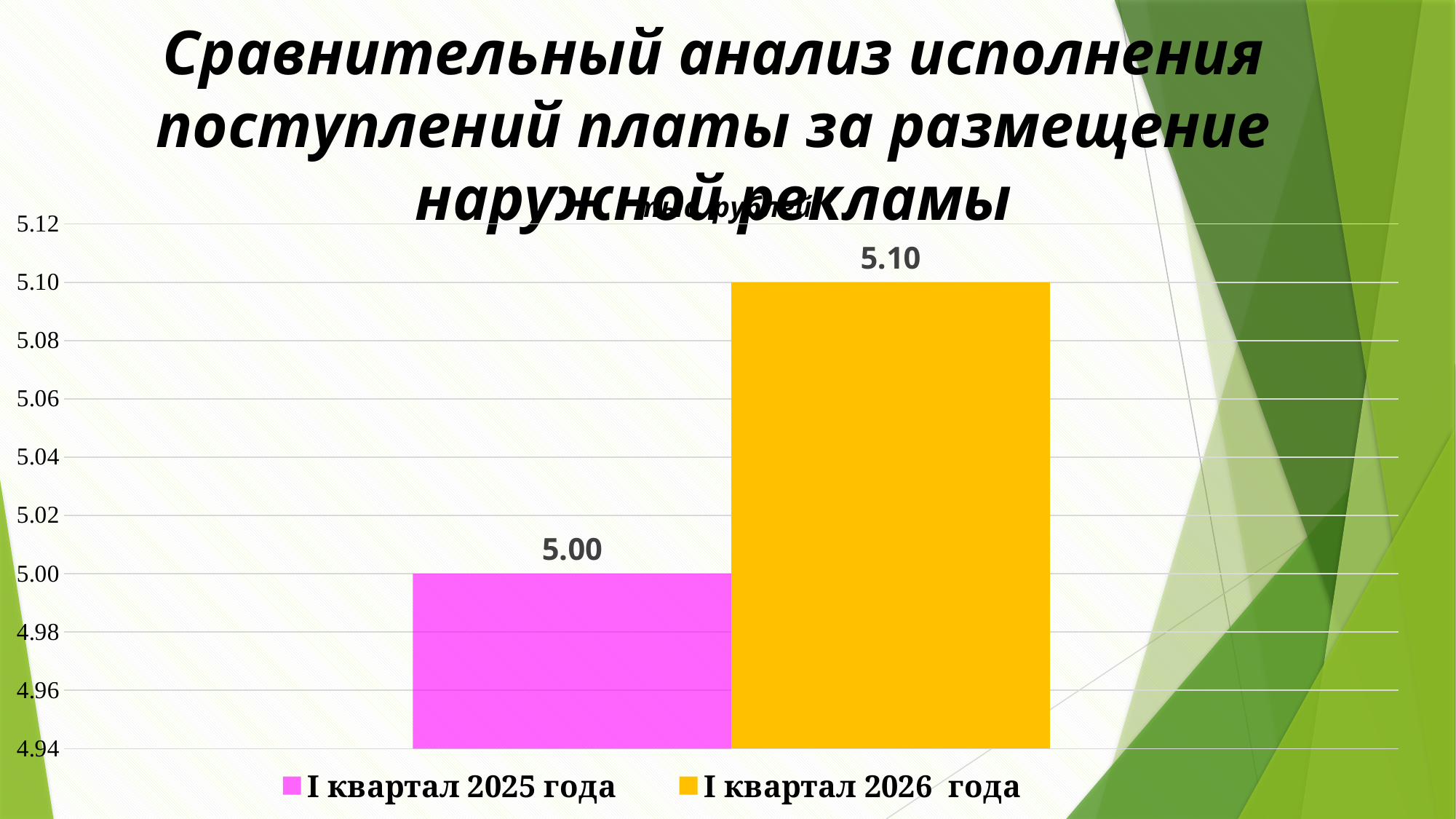
What is the difference between the values for I квартал 2026 года and I квартал 2025 года? 0.10 What colour is the bar for I квартал 2026 года? Yellow Which is larger: the value for I квартал 2025 года or for I квартал 2026 года? I квартал 2026 года Which series has the higher value? I квартал 2026 года What is the value for I квартал 2026 года? 5.10 Is the value for I квартал 2026 года greater or less than 5.04? greater How many bars are plotted on the chart? 2 How many series does the legend list? 2 What is the value for I квартал 2025 года? 5.00 Which series has the lower value? I квартал 2025 года What kind of chart is shown on the slide? Bar chart Is the value for I квартал 2025 года greater or less than 5.06? less